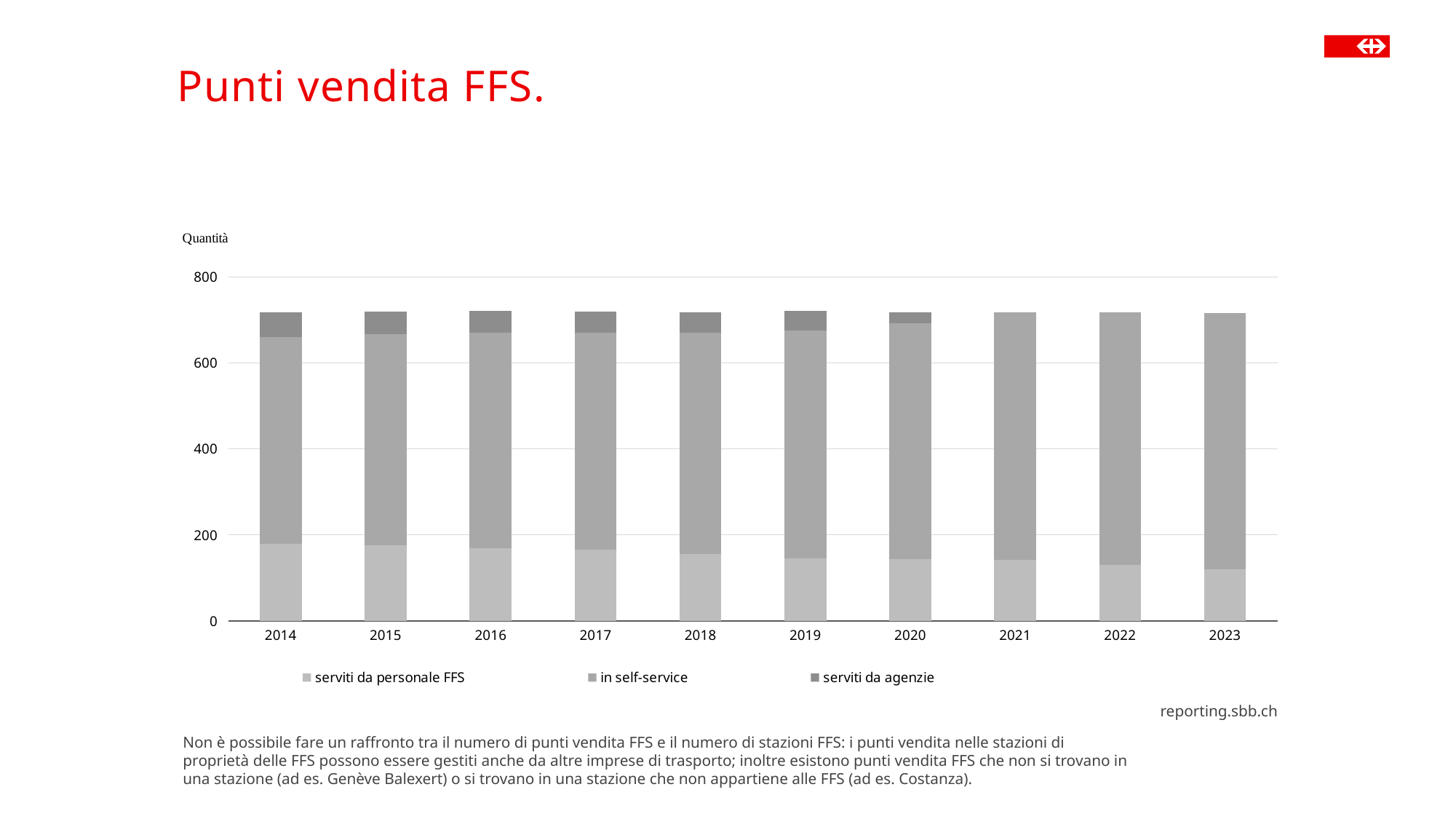
What is the title of the slide containing the chart? Punti vendita FFS. How many series does the legend list? 3 Does the 'serviti da personale FFS' series rise or fall from 2014 to 2023? fall Is the total height of the stacked bar for 2023 greater or less than 600? greater How many years are shown on the x axis of the chart? 10 Which series forms the largest segment of the stacked bar in 2023? in self-service What label is shown on the y axis of the chart? Quantità Is the value for 'serviti da personale FFS' in 2014 greater or less than 200? less What kind of chart is shown on the slide? Stacked bar chart Is the value for 'serviti da personale FFS' in 2023 greater or less than 200? less Which is larger, the 'serviti da personale FFS' value in 2014 or in 2023? 2014